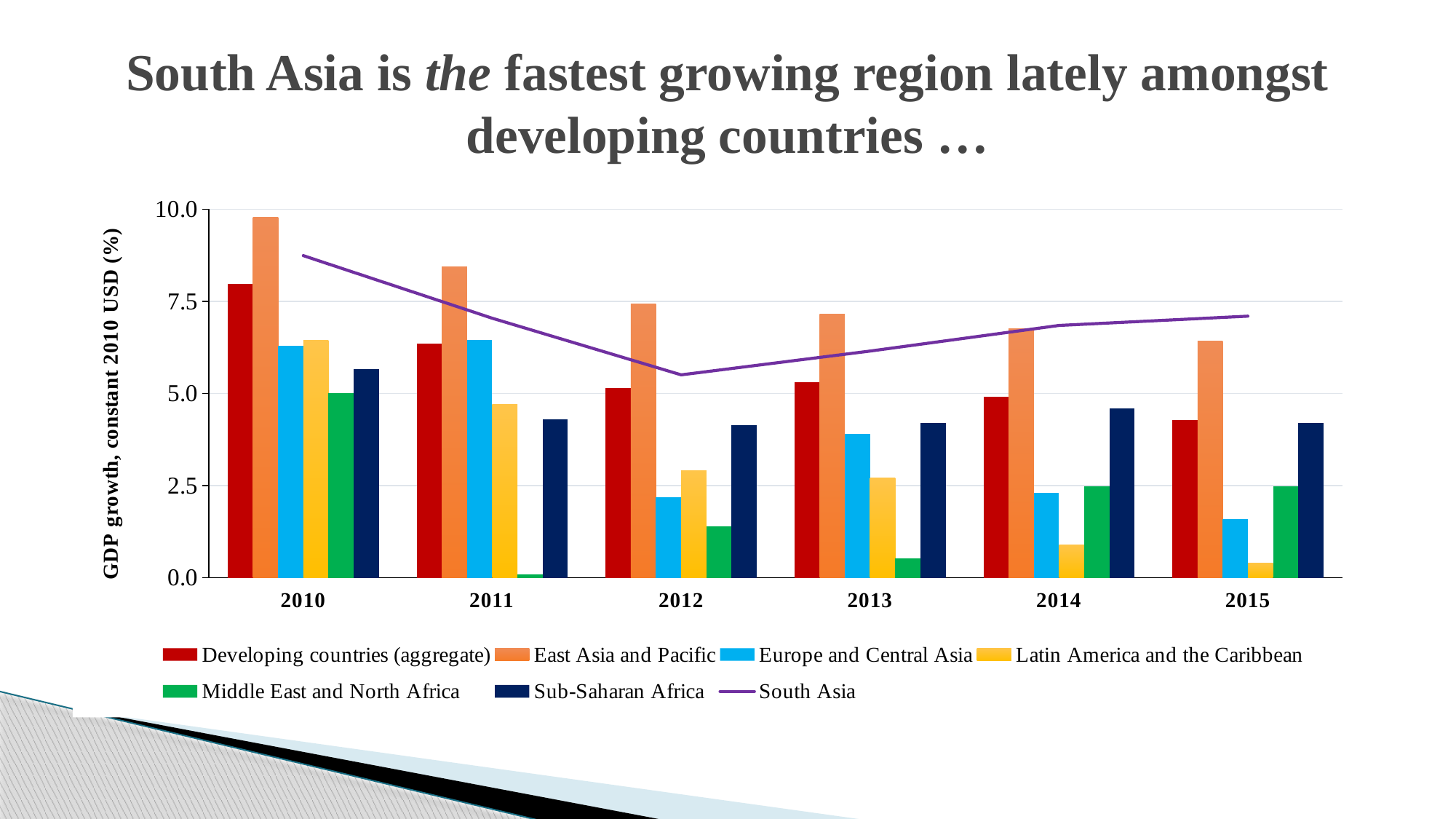
Which series is plotted as a line rather than bars? South Asia Which region has the lowest bar in 2011? Middle East and North Africa What kind of chart is shown on the slide? A bar chart combined with a line Is the value for Latin America and the Caribbean in 2015 greater or less than 2.5? less Is the value for East Asia and Pacific in 2010 greater or less than 7.5? greater Is the South Asia value in 2010 greater or less than 7.5? greater How many years are shown on the x axis? 6 Which region has the lowest bar in 2015? Latin America and the Caribbean Which region has the highest bar in 2010? East Asia and Pacific Do the East Asia and Pacific bars rise or fall from 2010 to 2015? fall How many series does the legend list? 7 In 2012, which is larger: Sub-Saharan Africa or Europe and Central Asia? Sub-Saharan Africa